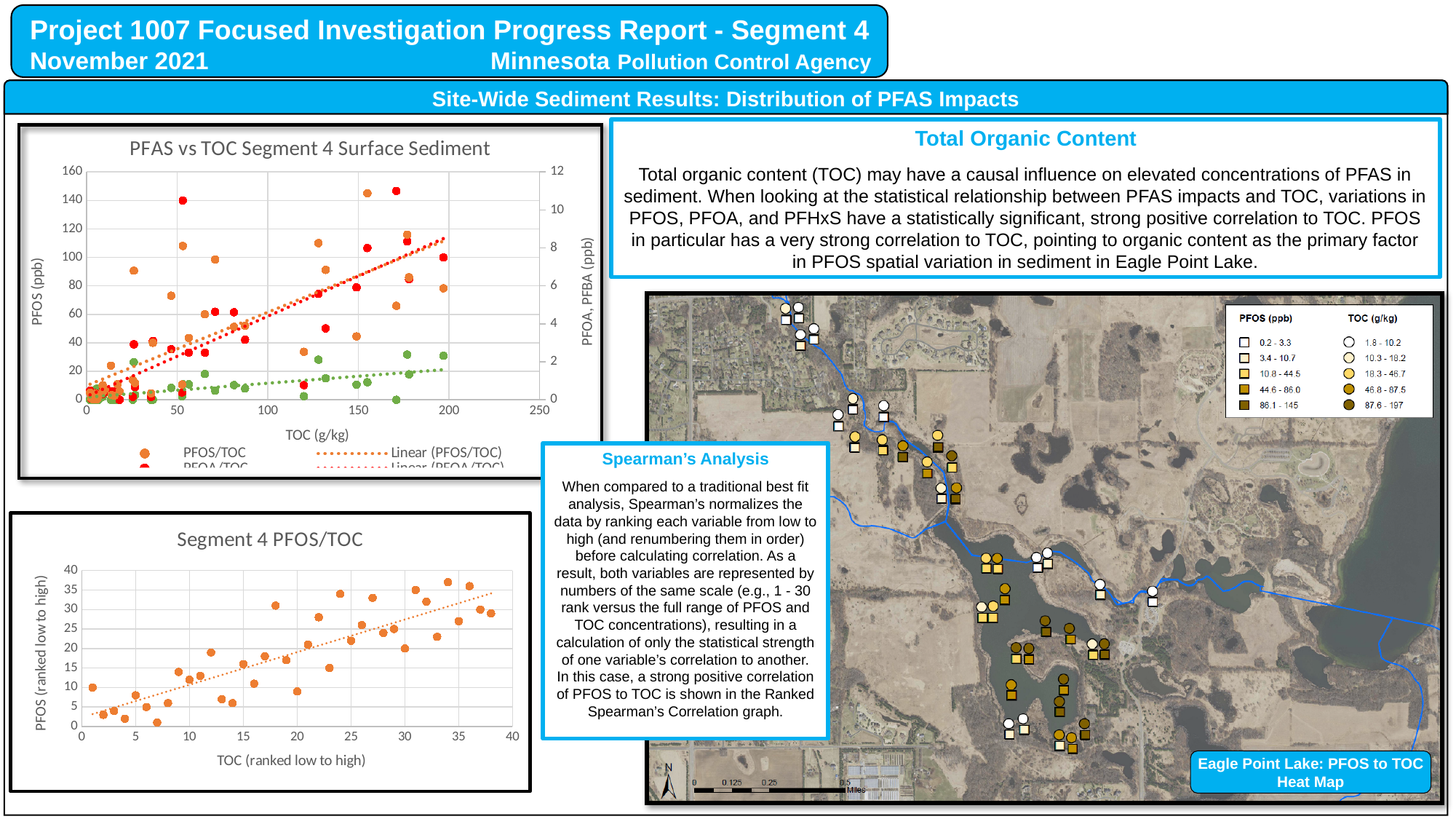
What is the y-axis title of the 'Segment 4 PFOS/TOC' chart? PFOS (ranked low to high) What kind of chart is the 'PFAS vs TOC Segment 4 Surface Sediment' chart? scatter chart What is the x-axis title of the 'PFAS vs TOC Segment 4 Surface Sediment' chart? TOC (g/kg) What kind of chart is the 'Segment 4 PFOS/TOC' chart? scatter chart In the 'Segment 4 PFOS/TOC' chart, is the PFOS rank for the point at TOC rank 7 greater or less than 5? less In the 'Segment 4 PFOS/TOC' chart, do the PFOS ranks generally rise or fall as the TOC rank increases? rise In the 'PFAS vs TOC Segment 4 Surface Sediment' chart, does the PFOS/TOC linear trend line rise or fall as TOC increases? rise In the 'PFAS vs TOC Segment 4 Surface Sediment' chart, what is the highest value shown on the right y-axis? 12 In the 'Segment 4 PFOS/TOC' chart, what is the highest value shown on the x-axis? 40 In the 'PFAS vs TOC Segment 4 Surface Sediment' chart, what is the highest value shown on the left y-axis? 160 In the 'Segment 4 PFOS/TOC' chart, is the PFOS rank for the point at TOC rank 1 greater or less than 5? greater